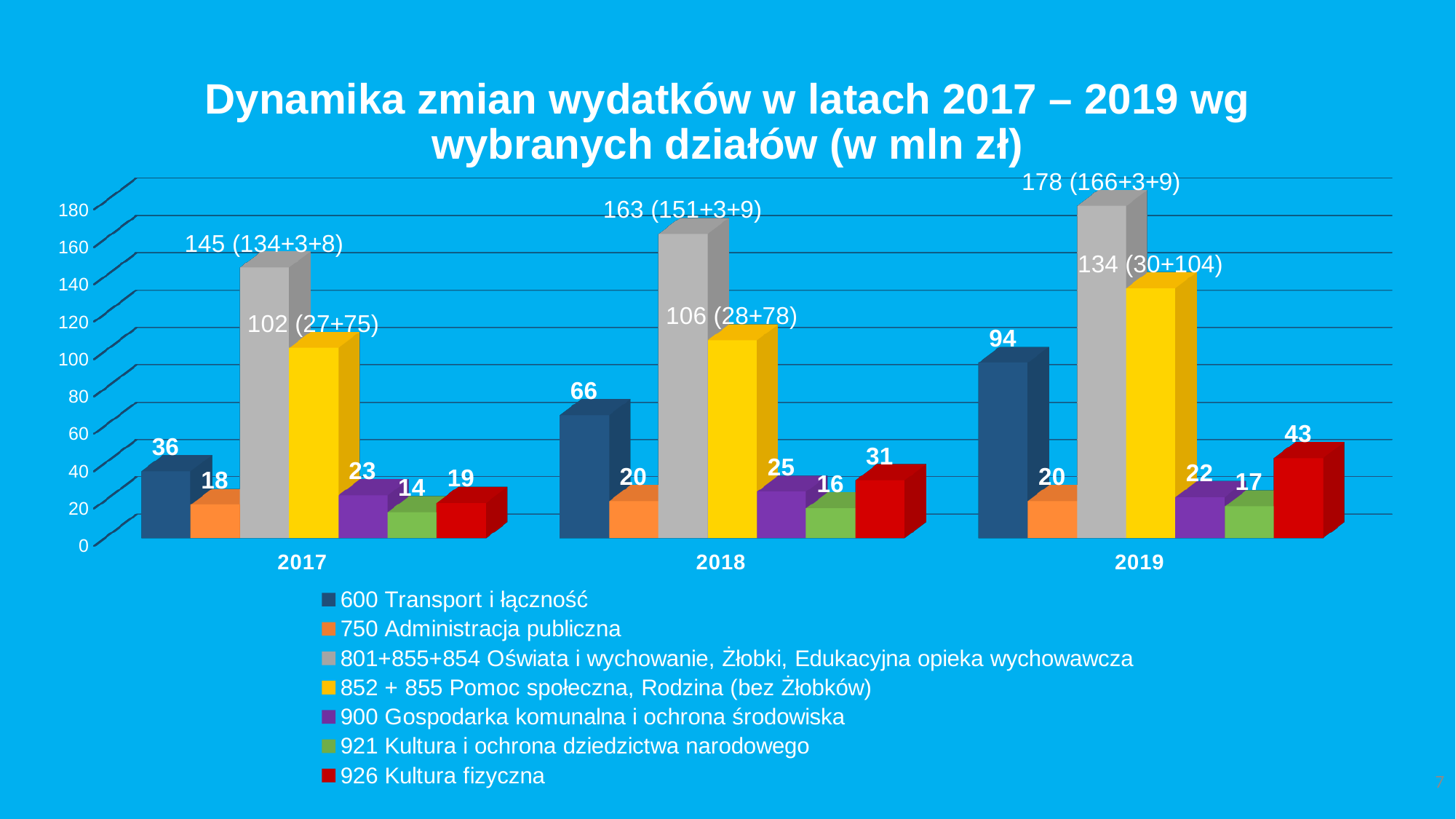
Do the values for 600 Transport i łączność rise or fall from 2017 to 2019? Rise Which series has the highest value in 2018? 801+855+854 Oświata i wychowanie, Żłobki, Edukacyjna opieka wychowawcza What is the data label shown for 801+855+854 Oświata i wychowanie, Żłobki, Edukacyjna opieka wychowawcza in 2017? 145 (134+3+8) What is the data label shown for 852 + 855 Pomoc społeczna, Rodzina (bez Żłobków) in 2019? 134 (30+104) What is the value for 926 Kultura fizyczna in 2018? 31 Which series has the lowest value in 2017? 921 Kultura i ochrona dziedzictwa narodowego What is the difference between the 600 Transport i łączność values for 2019 and 2017? 58 What is the value for 600 Transport i łączność in 2019? 94 Which is larger: 900 Gospodarka komunalna i ochrona środowiska in 2018 or 926 Kultura fizyczna in 2018? 926 Kultura fizyczna in 2018 What kind of chart is shown on the slide? Bar chart How many series does the legend list? 7 How many year categories are shown on the x axis? 3